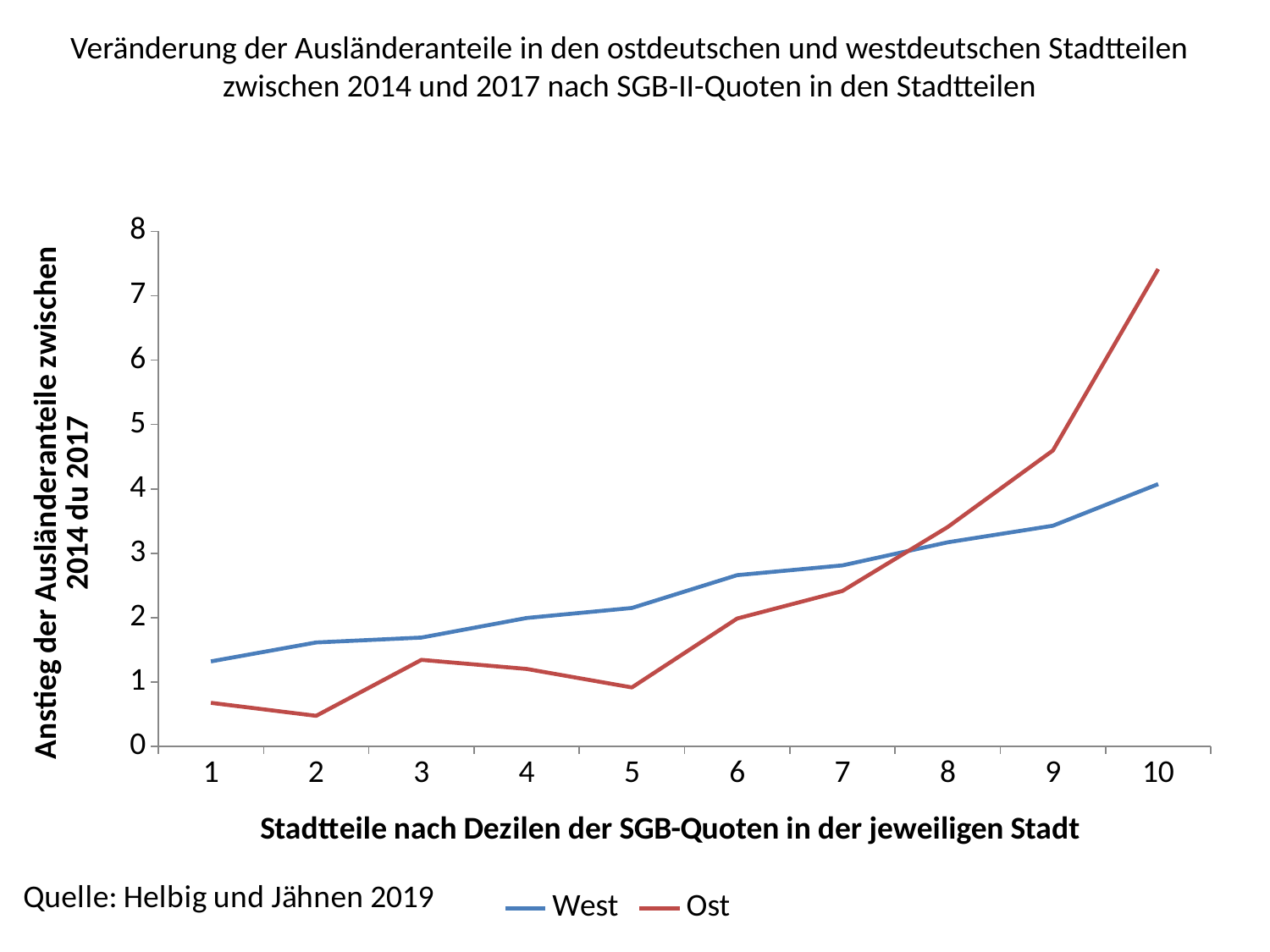
Does the West series rise or fall from decile 1 to decile 10? rise At decile 5, which series has the larger value, West or Ost? West Is the value for West at decile 10 greater or less than 3? greater At which decile does the West series reach its highest value? 10 What kind of chart is shown on the slide? line chart Is the value for Ost at decile 10 greater or less than 7? greater At which decile does the Ost series reach its highest value? 10 How many series does the legend list? 2 At which decile does the Ost series reach its lowest value? 2 How many deciles are plotted along the x axis? 10 At decile 9, which series has the larger value, West or Ost? Ost Is the value for Ost at decile 2 greater or less than 1? less